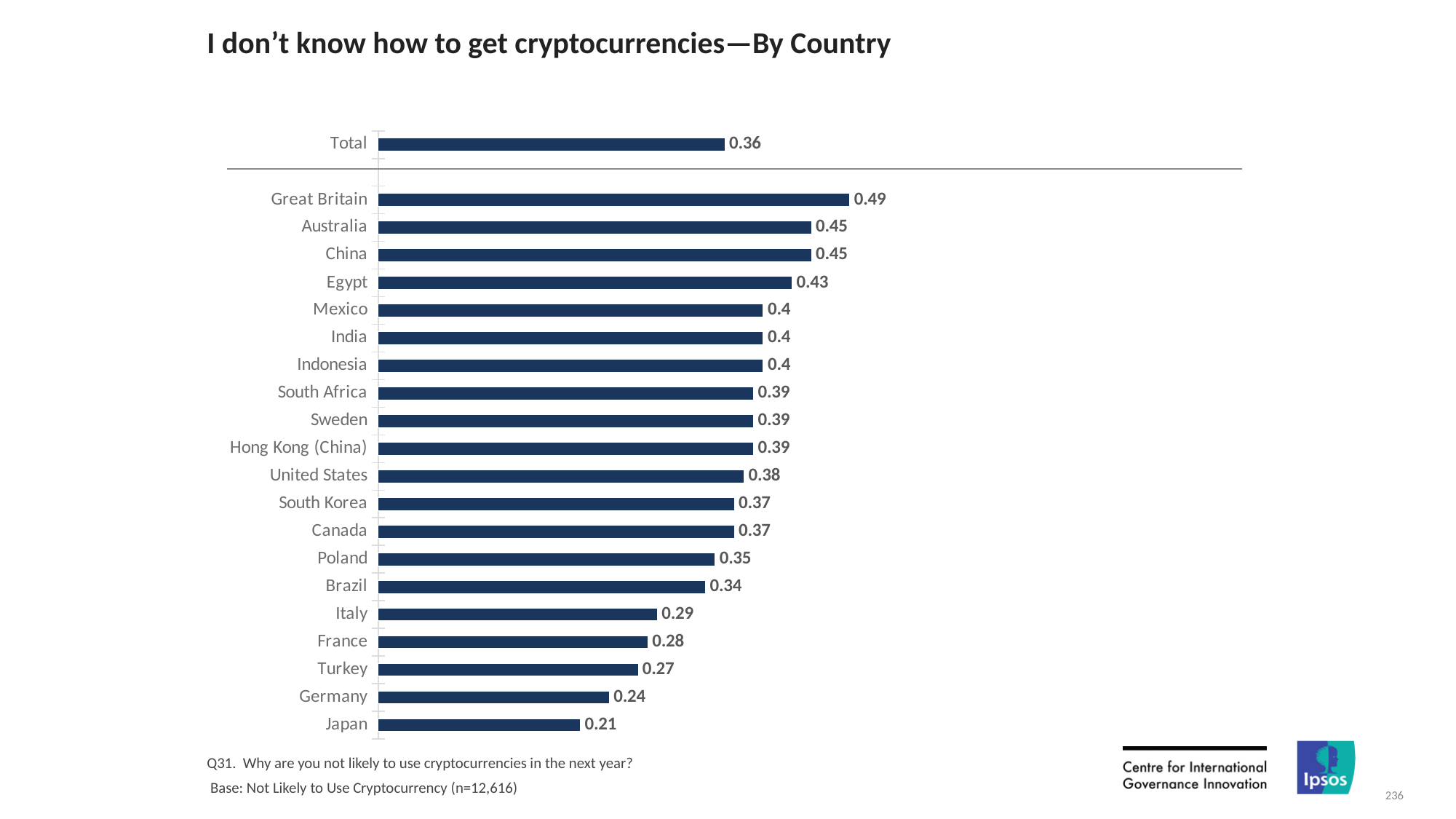
What is the value for Great Britain? 0.49 What is the title of the chart? I don't know how to get cryptocurrencies—By Country What kind of chart is shown on the slide? Bar chart Which country has the lowest value? Japan What is the value for Egypt? 0.43 What is the value for Japan? 0.21 What is the difference between the values for Great Britain and Japan? 0.28 Which has a larger value, Italy or Brazil? Brazil Which country has the highest value? Great Britain What is the difference between the values for Germany and Turkey? 0.03 What is the value for the Total bar? 0.36 How many countries are listed in the chart (excluding Total)? 20